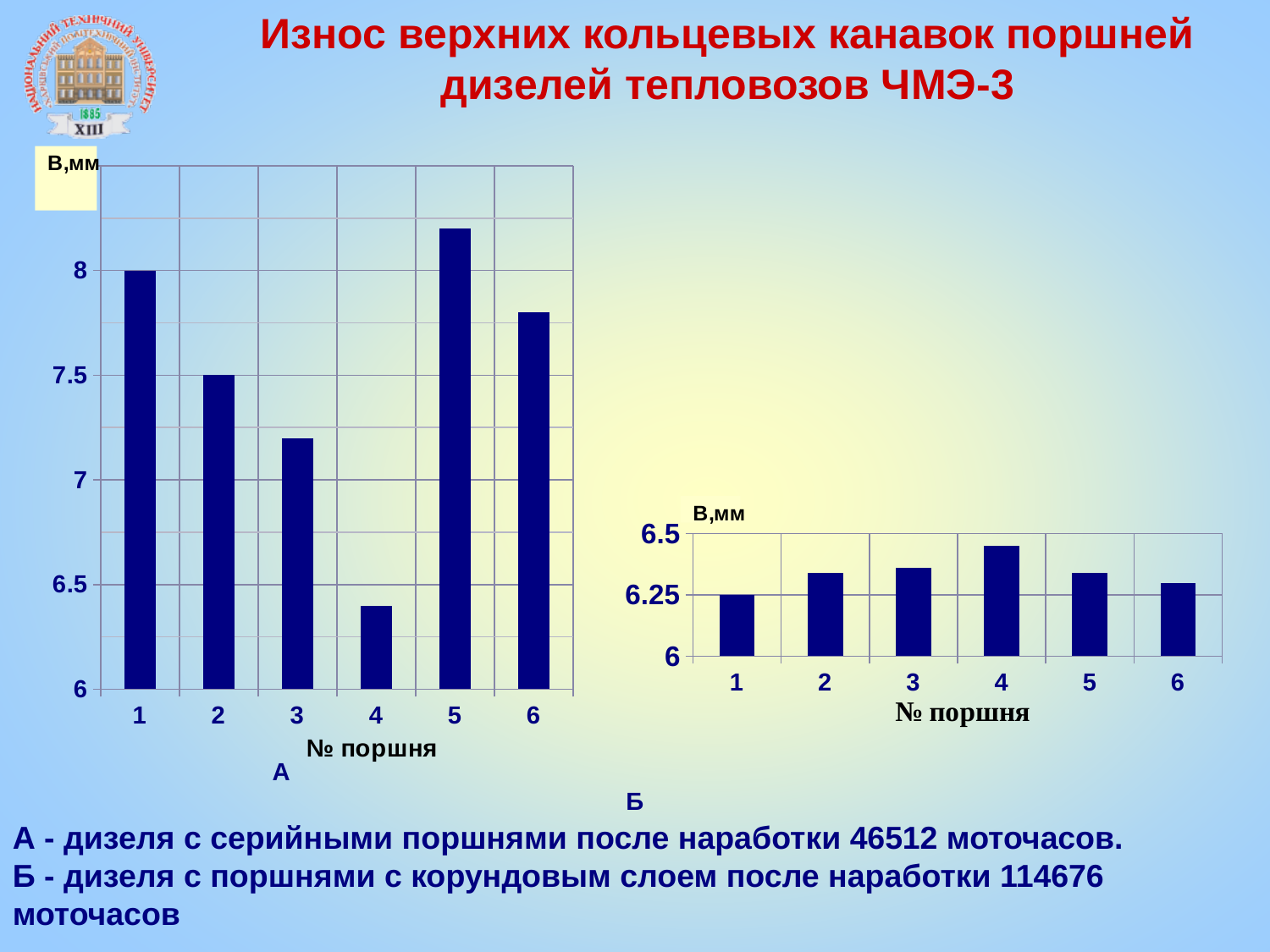
How many pistons (bars) are shown on chart Б (right)? 6 On chart А (left), what is the difference between the values for piston № 1 and piston № 2? 0.5 On chart А (left), which piston number has the highest bar? 5 On chart А (left), which piston number has the lowest bar? 4 On chart А (left), is the value for piston № 4 greater or less than 6.5? less On chart А (left), what is the value for piston № 1? 8 On chart А (left), what is the value for piston № 2? 7.5 On chart А (left), is the value for piston № 3 greater or less than 7? greater On chart Б (right), which piston number has the highest bar? 4 On chart Б (right), what is the value for piston № 1? 6.25 What type of chart is chart А (left)? bar chart On chart Б (right), is the value for piston № 4 greater or less than 6.25? greater